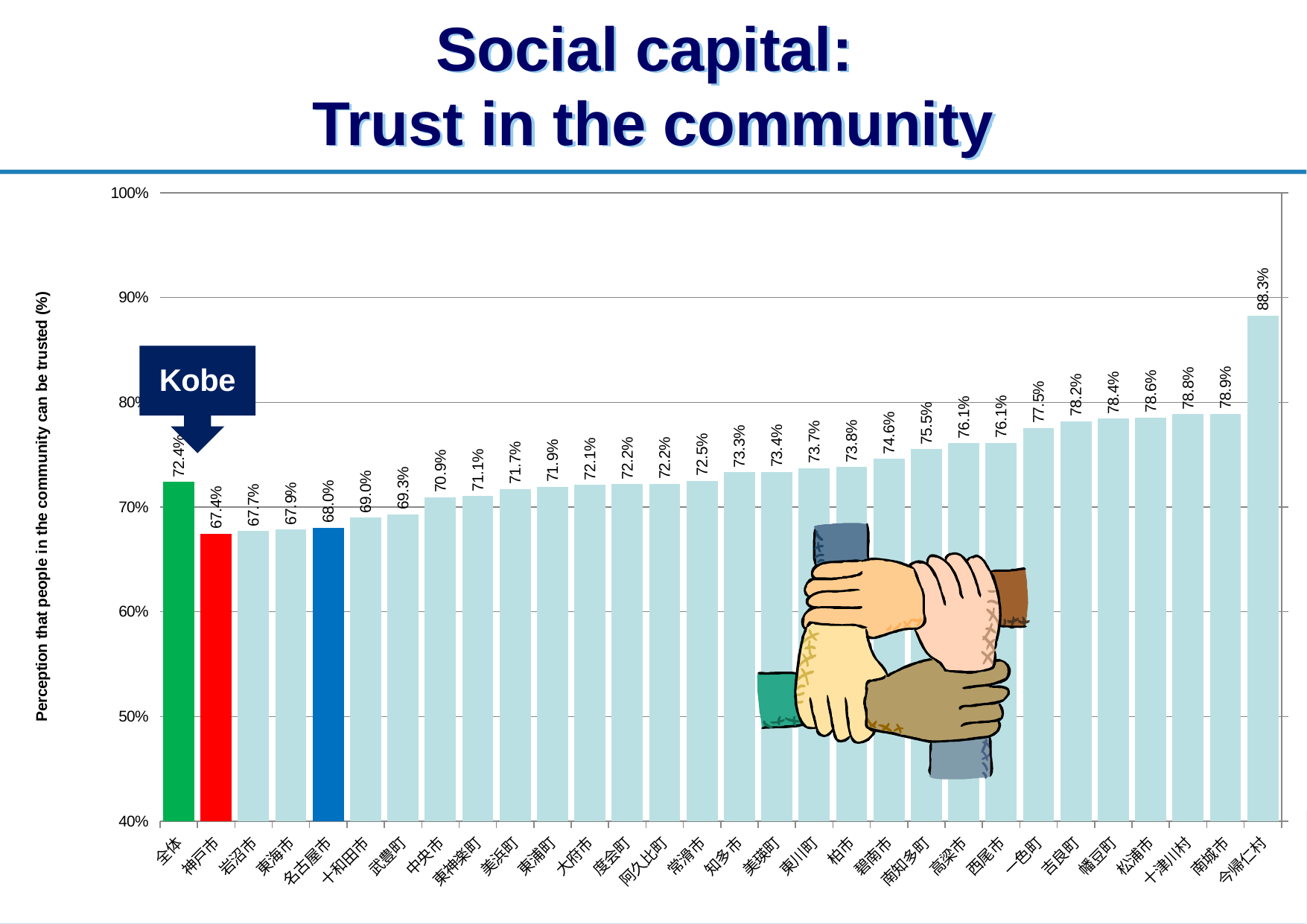
What is the value for 全体? 72.4% What is the difference between the values for 全体 and 神戸市? 5.0 percentage points What is the value for 神戸市? 67.4% What is the difference between the values for 今帰仁村 and 神戸市? 20.9 percentage points Which category has the lowest value? 神戸市 What is the value for 南城市? 78.9% Which category has the highest value? 今帰仁村 What kind of chart is shown on the slide? bar chart Which is larger, the value for 名古屋市 or the value for 十和田市? 十和田市 Is the value for 柏市 greater or less than 70%? greater Which category's bar is coloured red? 神戸市 How many categories are shown on the x axis? 30